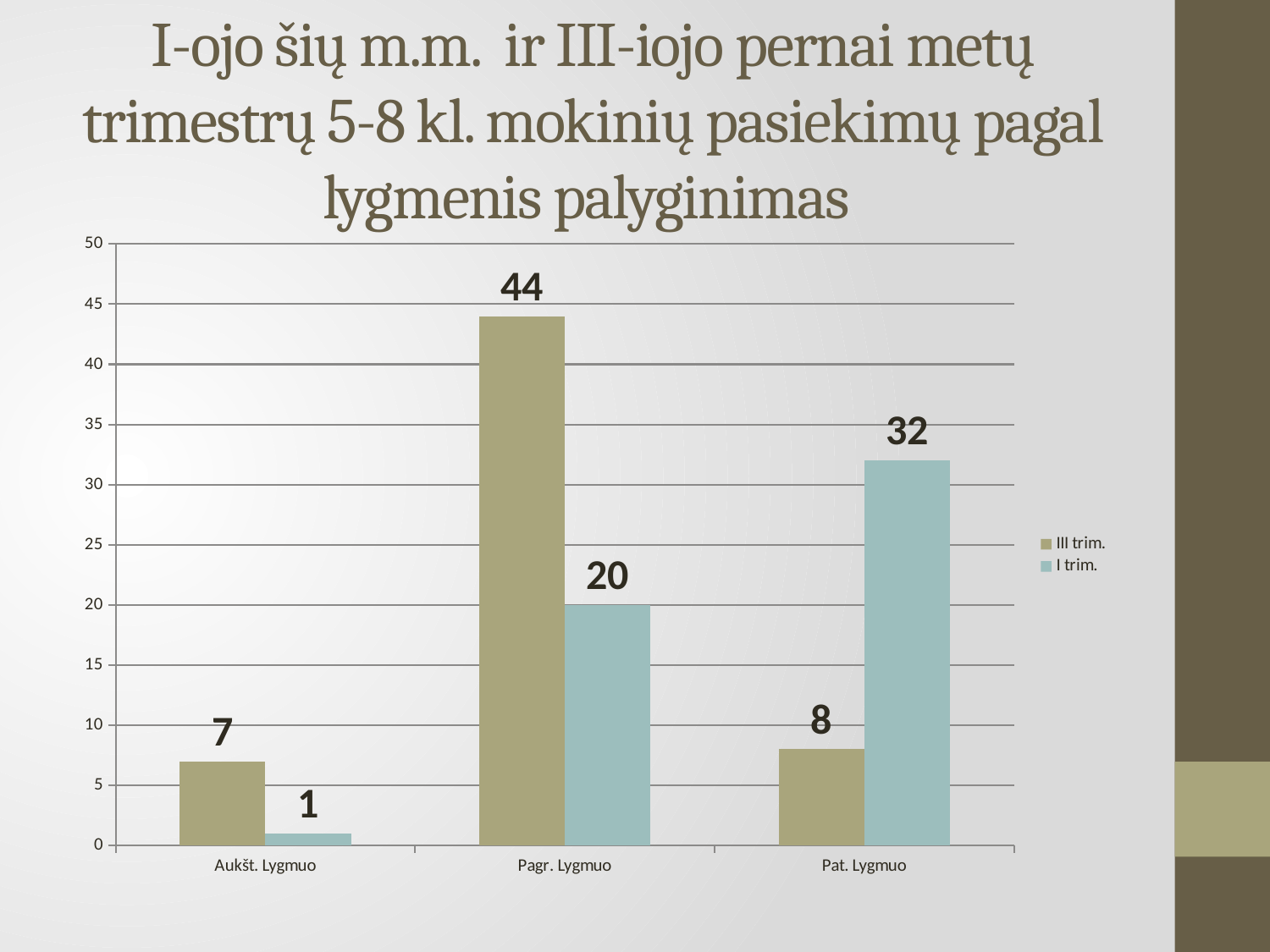
How many series does the legend list? 2 What is the difference between the III trim. and I trim. values in the Pagr. Lygmuo category? 24 What is the difference between the III trim. values for Pagr. Lygmuo and Aukšt. Lygmuo? 37 What is the value for I trim. in the Aukšt. Lygmuo category? 1 What is the value for III trim. in the Pat. Lygmuo category? 8 What kind of chart is shown on the slide? Bar chart What is the value for III trim. in the Pagr. Lygmuo category? 44 Which category has the highest value for III trim.? Pagr. Lygmuo What is the value for I trim. in the Pat. Lygmuo category? 32 How many categories are shown on the x axis? 3 In the Pat. Lygmuo category, which series has the larger value, III trim. or I trim.? I trim. Which category has the lowest value for I trim.? Aukšt. Lygmuo